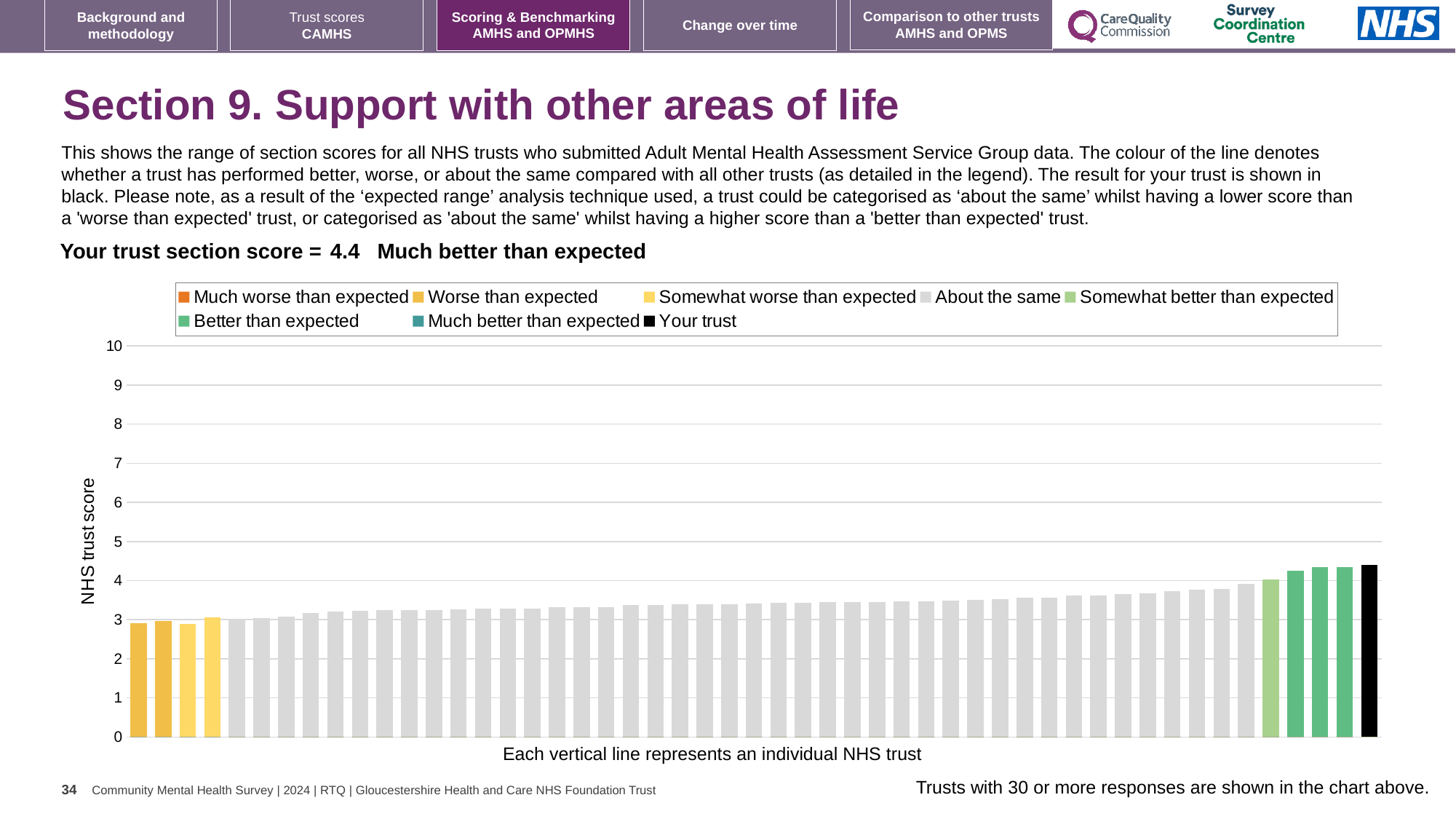
How many bars are shown in the 'Better than expected' colour? 3 Is the value of the 'Your trust' bar greater or less than 4? greater Which legend category does the rightmost (black) bar belong to? Your trust What kind of chart is shown on the slide? bar chart Is the value of the tallest bar greater or less than 5? less How many entries does the chart legend list? 8 What is the label on the y axis of the chart? NHS trust score How many bars are shown in the 'Much worse than expected' colour? 0 What is the section score for 'Your trust' shown on the slide? 4.4 Do the bar values rise or fall from left to right along the x axis? rise Is the value of the shortest bar greater or less than 2? greater